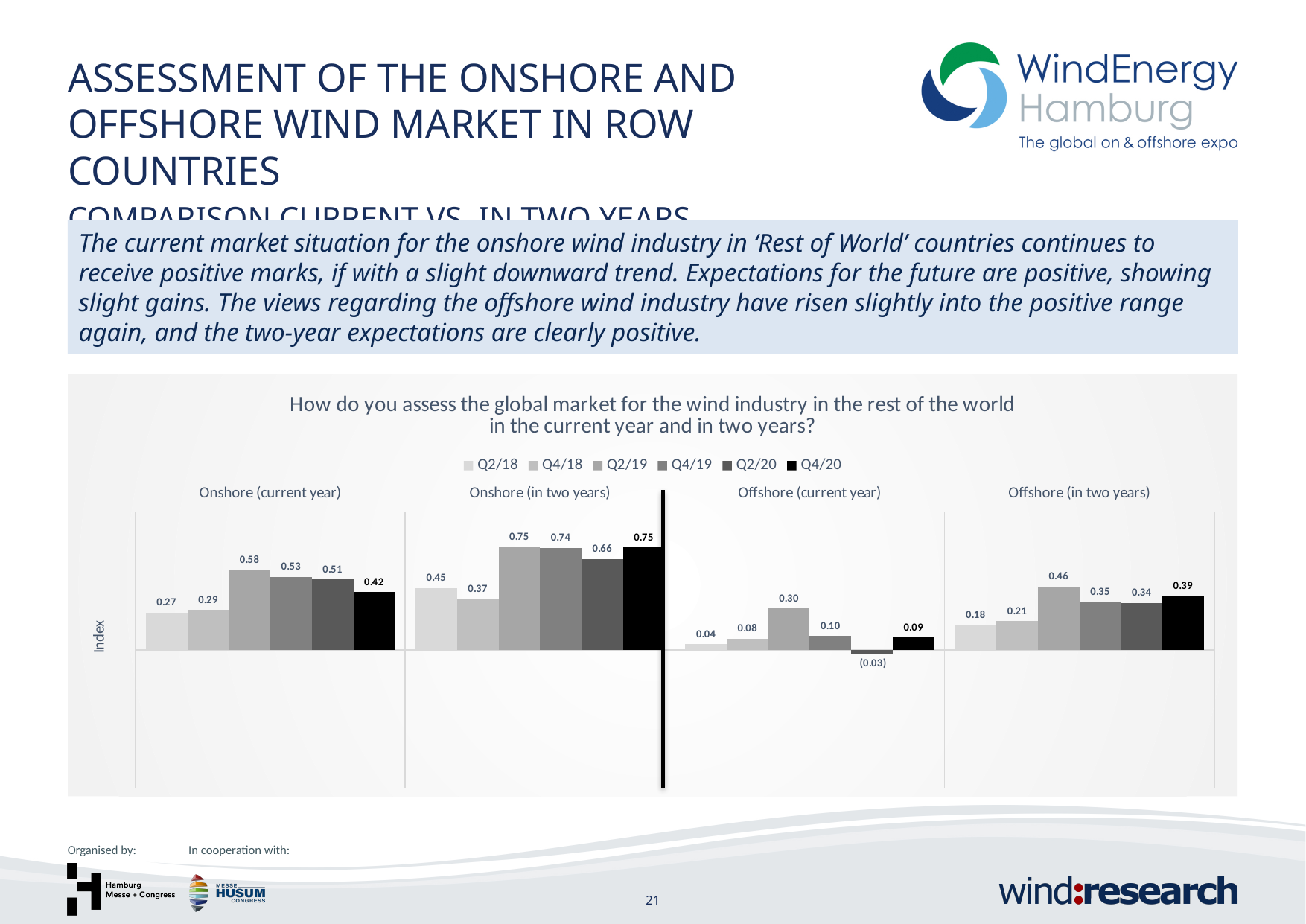
Which series has the highest value in the Onshore (current year) group? Q2/19 Which series is shown in black in the legend? Q4/20 Which series has the lowest value in the Offshore (current year) group? Q2/20 What kind of chart is shown on the slide? Bar chart What is the Q2/20 value for Offshore (current year)? (0.03) What is the Q2/19 value for Offshore (current year)? 0.30 What is the difference between the Q2/19 and Q4/20 values for Onshore (current year)? 0.16 What is the Q4/20 value for Onshore (current year)? 0.42 How many category groups are shown on the x axis? 4 How many series does the legend list? 6 Which is larger for Offshore (in two years): the Q2/19 value or the Q4/20 value? Q2/19 What is the Q4/20 value for Offshore (in two years)? 0.39